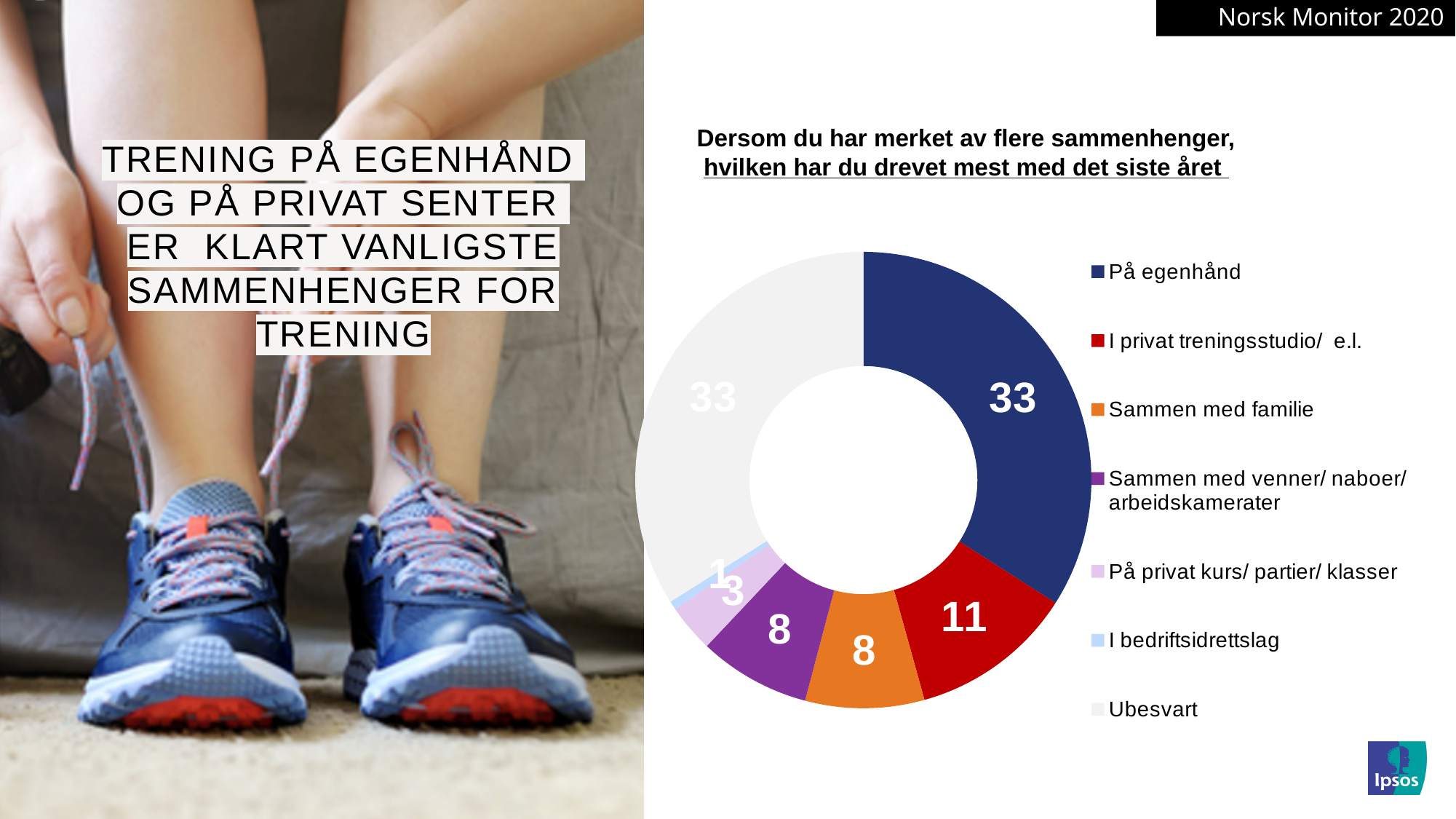
How many categories does the legend of the chart list? 7 Which category has the lowest value in the chart? I bedriftsidrettslag What is the difference between the values for "Sammen med venner/ naboer/ arbeidskamerater" and "På privat kurs/ partier/ klasser"? 5 What value is shown for "I privat treningsstudio/ e.l."? 11 What value is shown for "Ubesvart"? 33 Which is larger: the value for "I privat treningsstudio/ e.l." or the value for "Sammen med familie"? I privat treningsstudio/ e.l. Which colour represents "Sammen med familie" in the chart? Orange What kind of chart is shown on the slide? Donut (pie) chart What value is shown for "På egenhånd" in the donut chart? 33 What value is shown for "På privat kurs/ partier/ klasser"? 3 What is the difference between the values for "På egenhånd" and "I privat treningsstudio/ e.l."? 22 What value is shown for "Sammen med familie"? 8